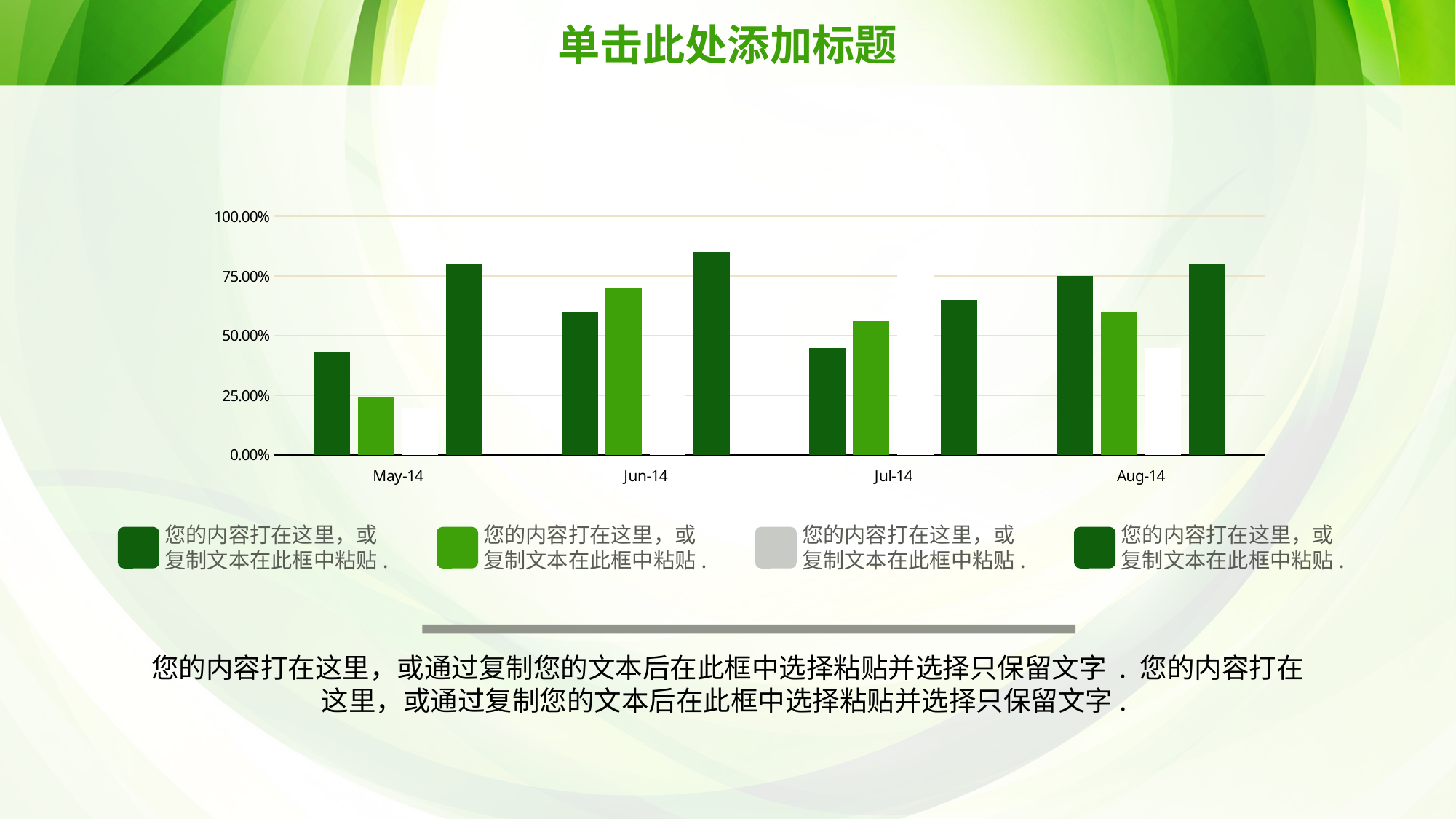
In the Aug-14 group, which is larger: the first (dark green) bar or the second (light green) bar? the first (dark green) bar Is the value of the second (light green) bar for Jun-14 greater or less than 50.00%? greater Which category on the x axis contains the tallest bar in the chart? Jun-14 What is the highest value shown on the chart's y axis? 100.00% Is the value of the fourth (rightmost) bar for Jun-14 greater or less than 75.00%? greater How many categories are shown on the x axis of the chart? 4 How many series does the chart's legend list? 4 Is the value of the fourth (rightmost) bar for Jul-14 greater or less than 50.00%? greater What kind of chart is shown on the slide? bar chart In the Jun-14 group, which is larger: the first (dark green) bar or the second (light green) bar? the second (light green) bar Within the May-14 group, which bar is the tallest: the first, second or fourth? the fourth